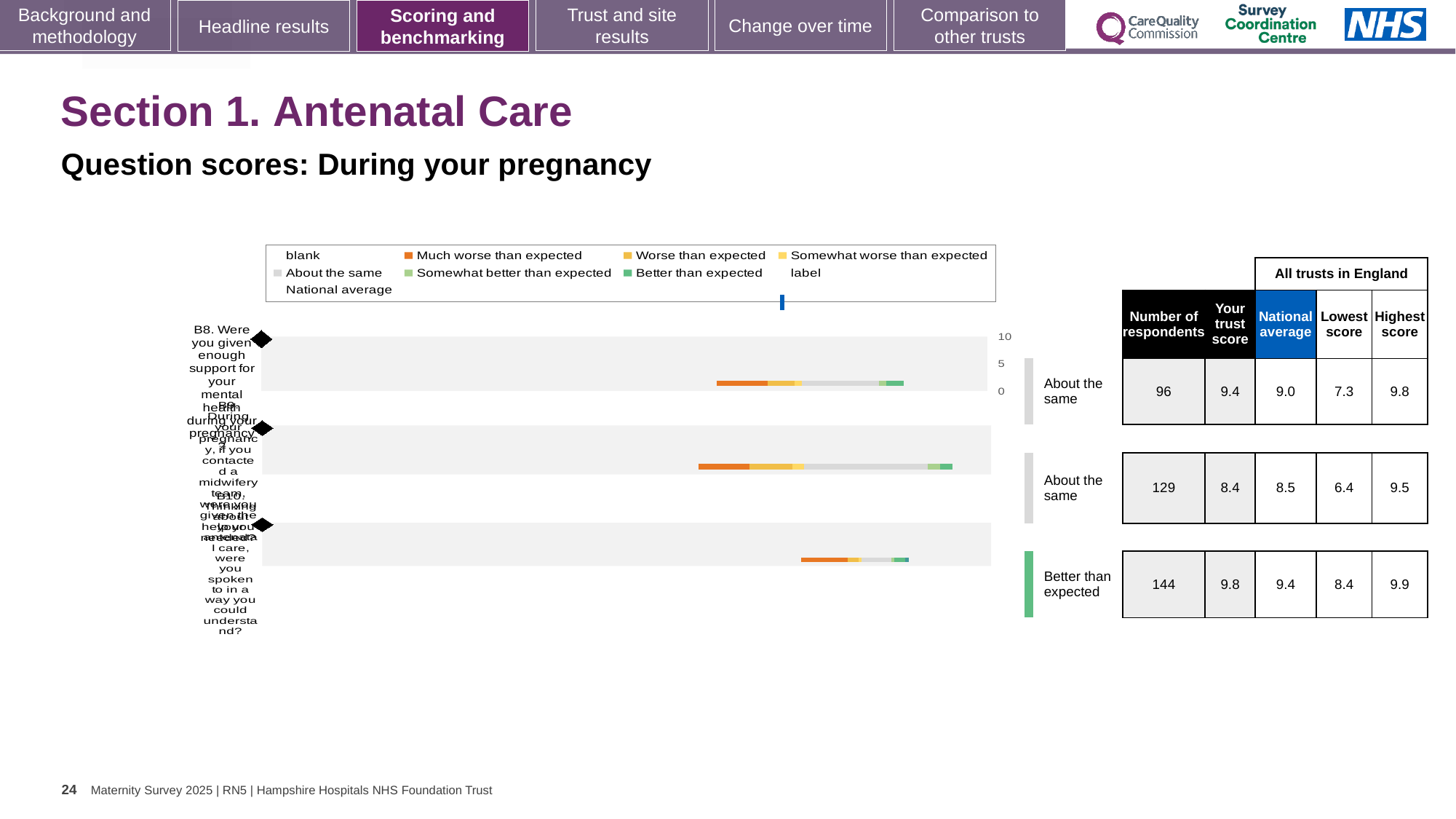
What benchmark category is shown for the bottom (third) row? Better than expected For the bottom (third) row, how much higher is the trust score than the national average? 0.4 In the table beside the chart, what is the trust score for the bottom (third) row? 9.8 In the table beside the chart, what is the number of respondents for the top row (question B8)? 96 How many question rows (bars) are plotted in the chart? 3 What kind of chart is shown on the slide? bar chart For the middle (second) row, which is larger: the trust score or the national average? national average In the table beside the chart, what is the national average for the middle (second) row? 8.5 For the top row (question B8), what is the difference between the highest score and the lowest score in the table? 2.5 What colour represents 'Much worse than expected' in the legend? orange In the table beside the chart, what is the lowest score for the bottom (third) row? 8.4 Which row in the table has the highest number of respondents? the bottom (third) row, 144